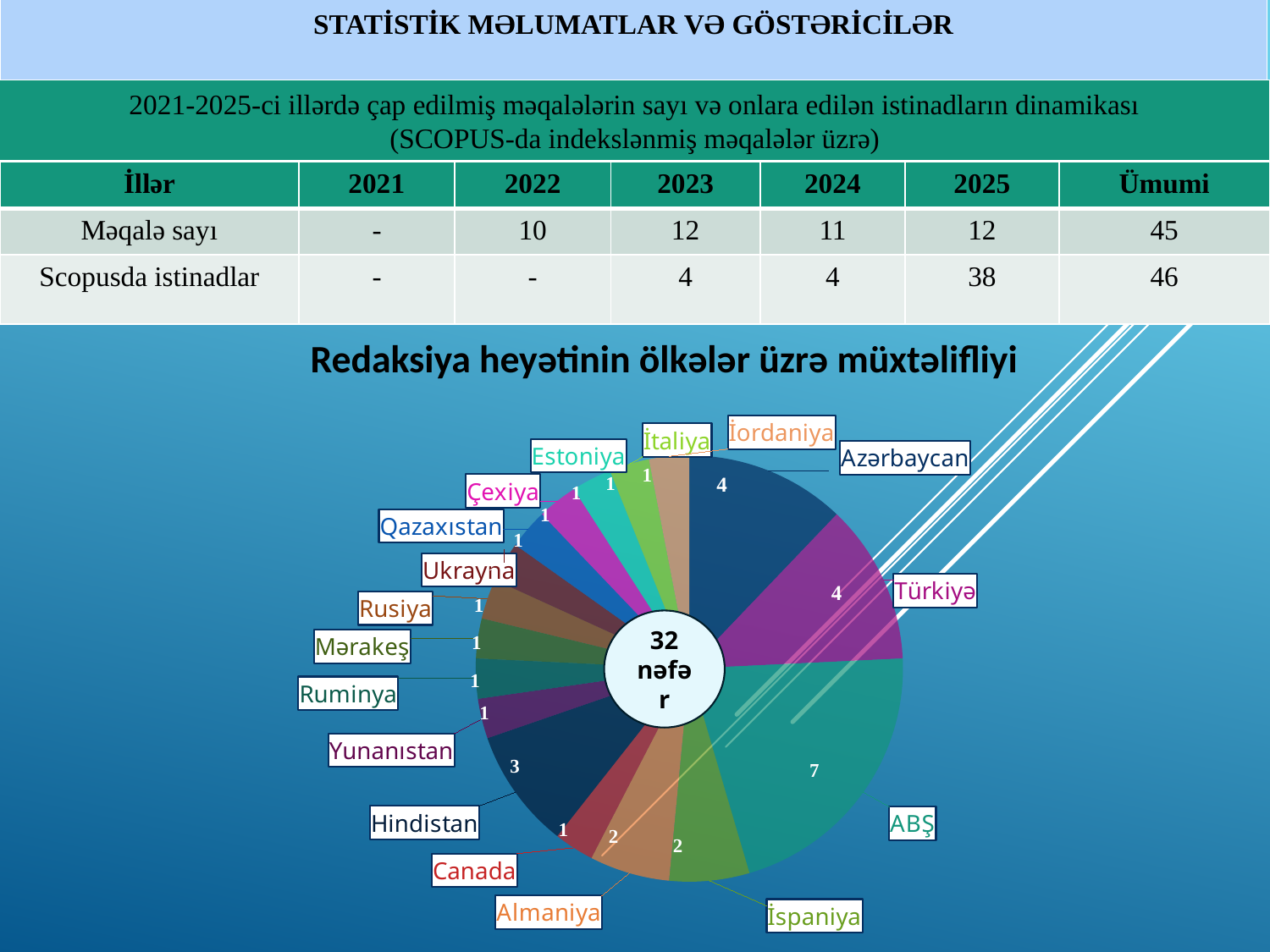
In the pie chart, what is the value for Canada? 1 What kind of chart is shown under the heading "Redaksiya heyətinin ölkələr üzrə müxtəlifliyi"? Pie chart In the pie chart, what is the value for Azərbaycan? 4 In the pie chart, which is larger, the value for Türkiyə or the value for Almaniya? Türkiyə In the pie chart, what is the value for ABŞ? 7 In the pie chart, what is the difference between the values for ABŞ and Hindistan? 4 How many countries are shown as slices in the pie chart? 17 In the pie chart, what is the value for Hindistan? 3 In the pie chart, which country has the largest slice? ABŞ What text is written in the centre of the pie chart? 32 nəfər In the pie chart, what is the value for İspaniya? 2 In the pie chart, which is larger, the value for ABŞ or the value for Azərbaycan? ABŞ